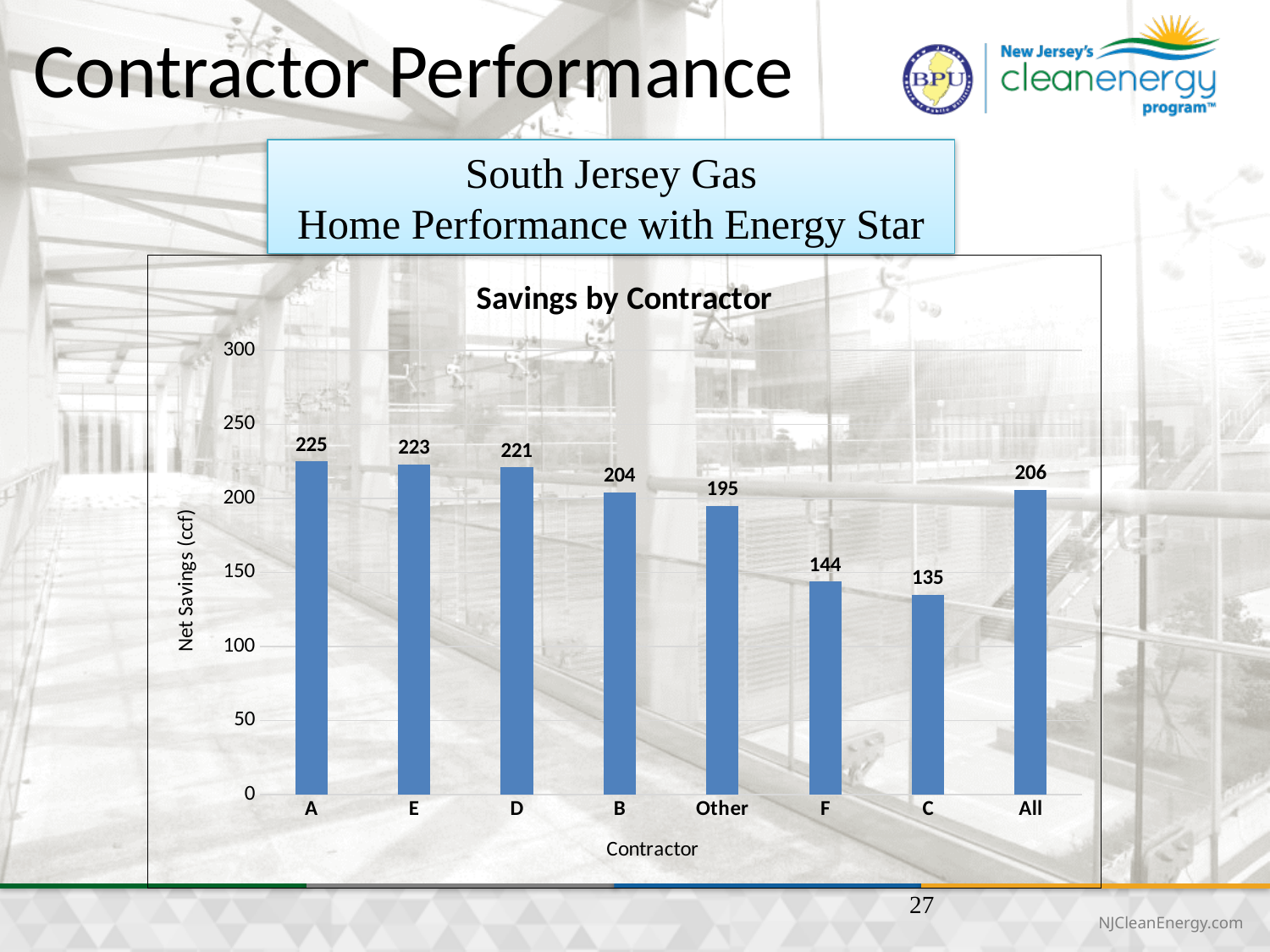
What is the title of the chart? Savings by Contractor What type of chart is shown on the slide? Bar chart What is the net savings value for the 'Other' category? 195 What is the difference in net savings between contractor B and contractor F? 60 What is the net savings value for contractor A? 225 What is the net savings value for 'All'? 206 Which has higher net savings, contractor D or contractor F? D Which contractor has the lowest net savings? C Is the value for contractor C greater or less than 150? less What is the difference in net savings between contractor A and contractor C? 90 Which contractor has the highest net savings? A How many bars are shown in the chart? 8